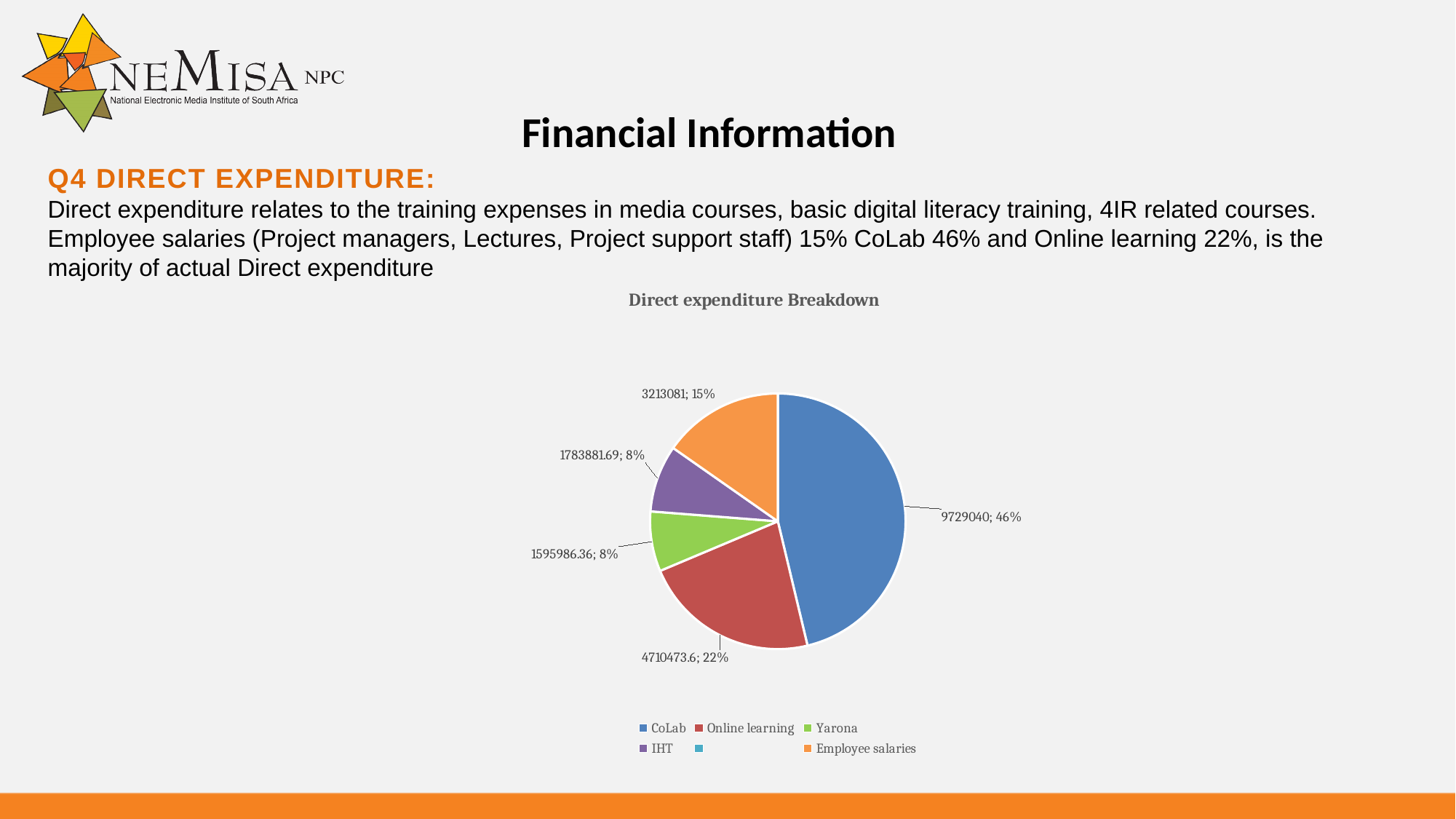
Which category has the smallest value in the pie chart? Yarona What is the value shown for CoLab in the pie chart? 9729040 What percentage of the pie is Employee salaries? 15% How many slices are shown in the pie chart? 5 What is the difference between the CoLab value and the Online learning value? 5018566.4 What is the title of the chart? Direct expenditure Breakdown Which category has the largest slice of the pie? CoLab What share of direct expenditure does CoLab account for? 46% What is the value shown for IHT? 1783881.69 What is the value shown for Online learning? 4710473.6 What type of chart is shown on the slide? pie chart Which is larger, the value for IHT or the value for Yarona? IHT